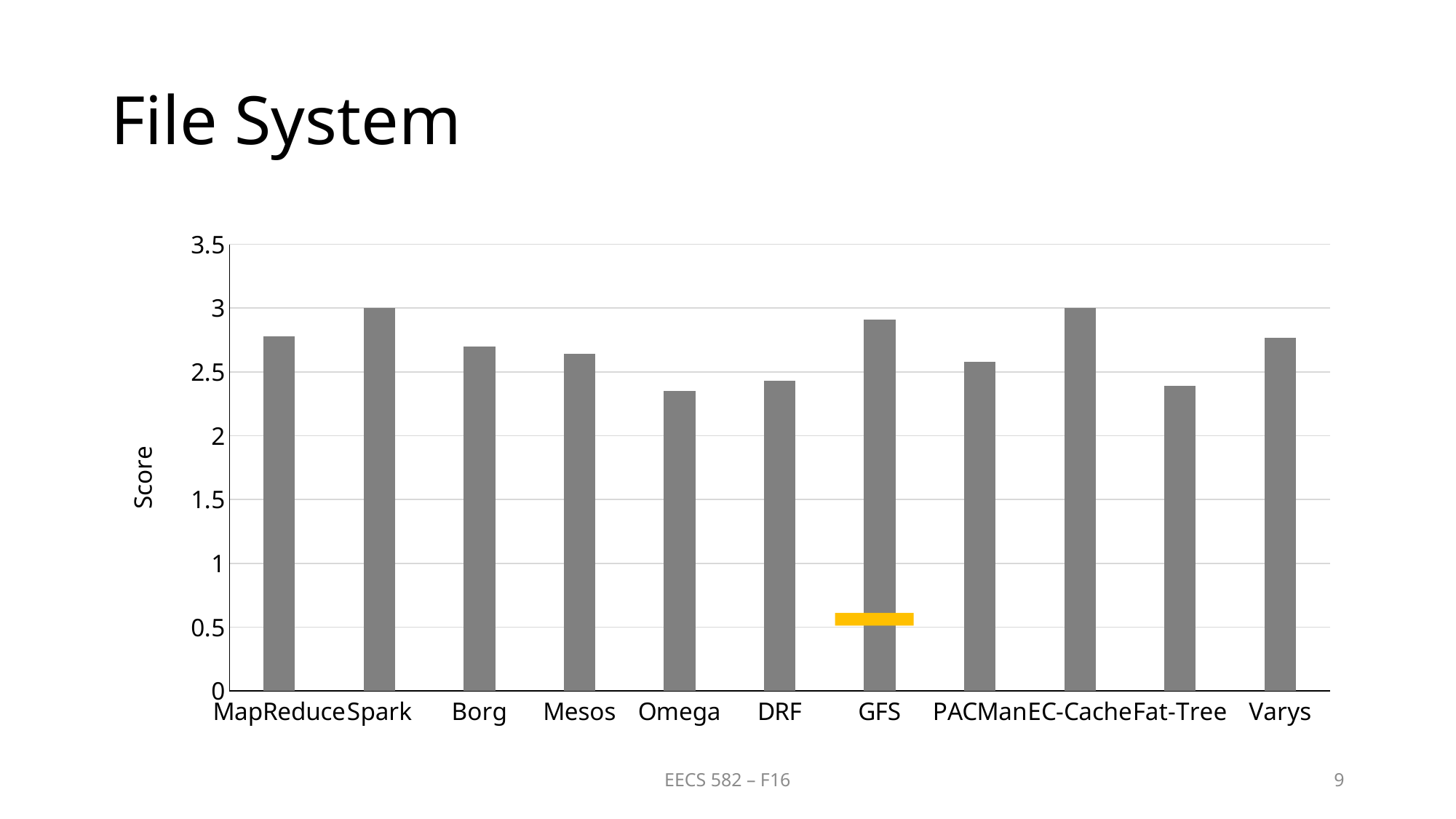
Is the value for Omega greater or less than 2.5? less What kind of chart is shown on the slide? bar chart Is the value for DRF greater or less than 2.5? less How many categories are plotted on the x axis? 11 Is the value for MapReduce greater or less than 2.5? greater What is the label on the y axis of the chart? Score Which has a higher score, GFS or Omega? GFS What is the score for EC-Cache? 3 Which has a higher score, Spark or DRF? Spark What is the score for Spark? 3